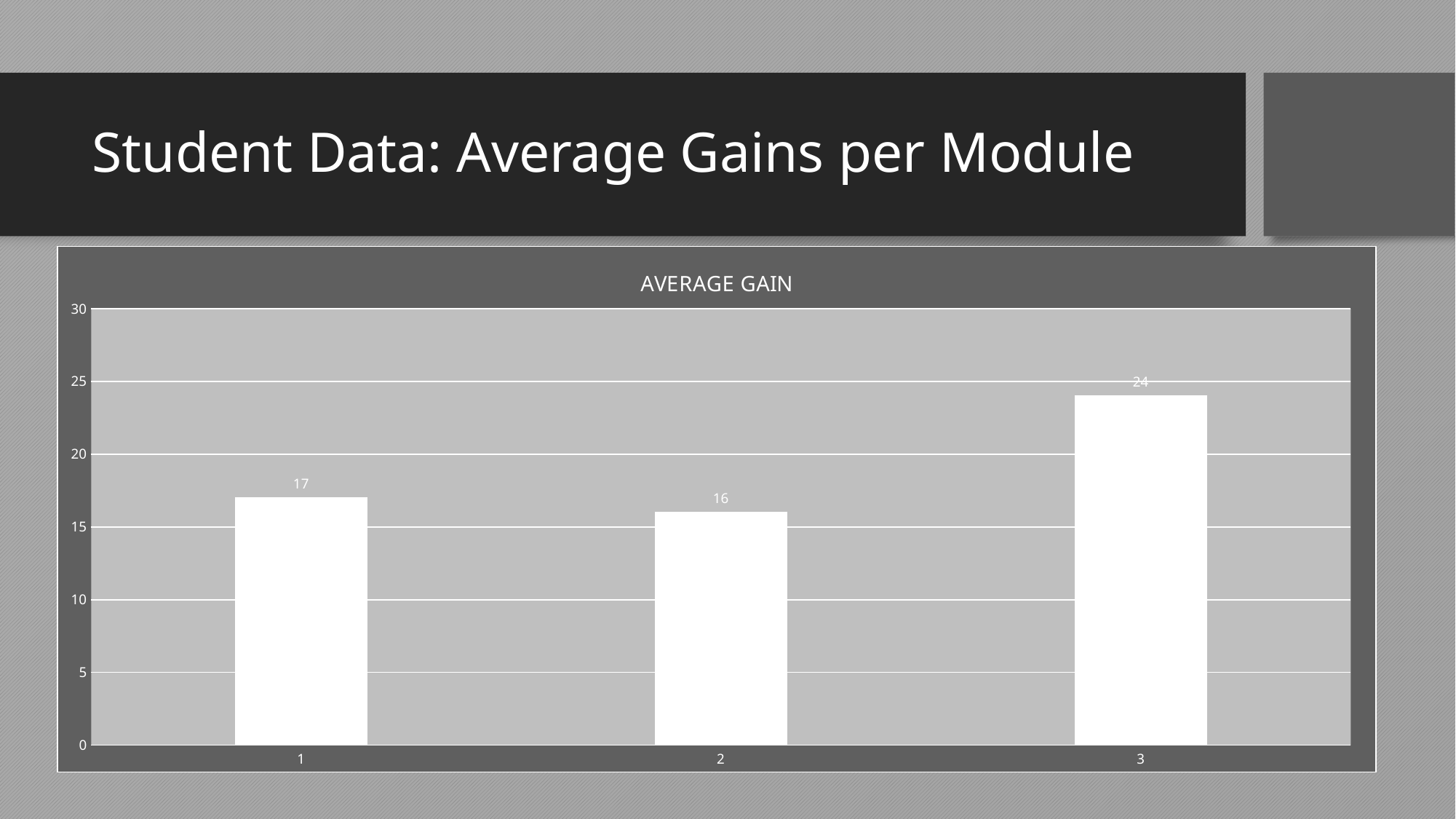
Which is larger, the average gain for module 3 or module 2? module 3 Which module has the lowest average gain? 2 How many modules are shown on the chart? 3 Which module has the highest average gain? 3 What is the average gain for module 3? 24 What is the difference between the average gain for module 3 and module 1? 7 Is the value for module 3 greater or less than 20? greater What is the difference between the average gain for module 1 and module 2? 1 What is the title of the chart? AVERAGE GAIN What is the average gain for module 2? 16 What is the average gain for module 1? 17 What kind of chart is shown on the slide? bar chart